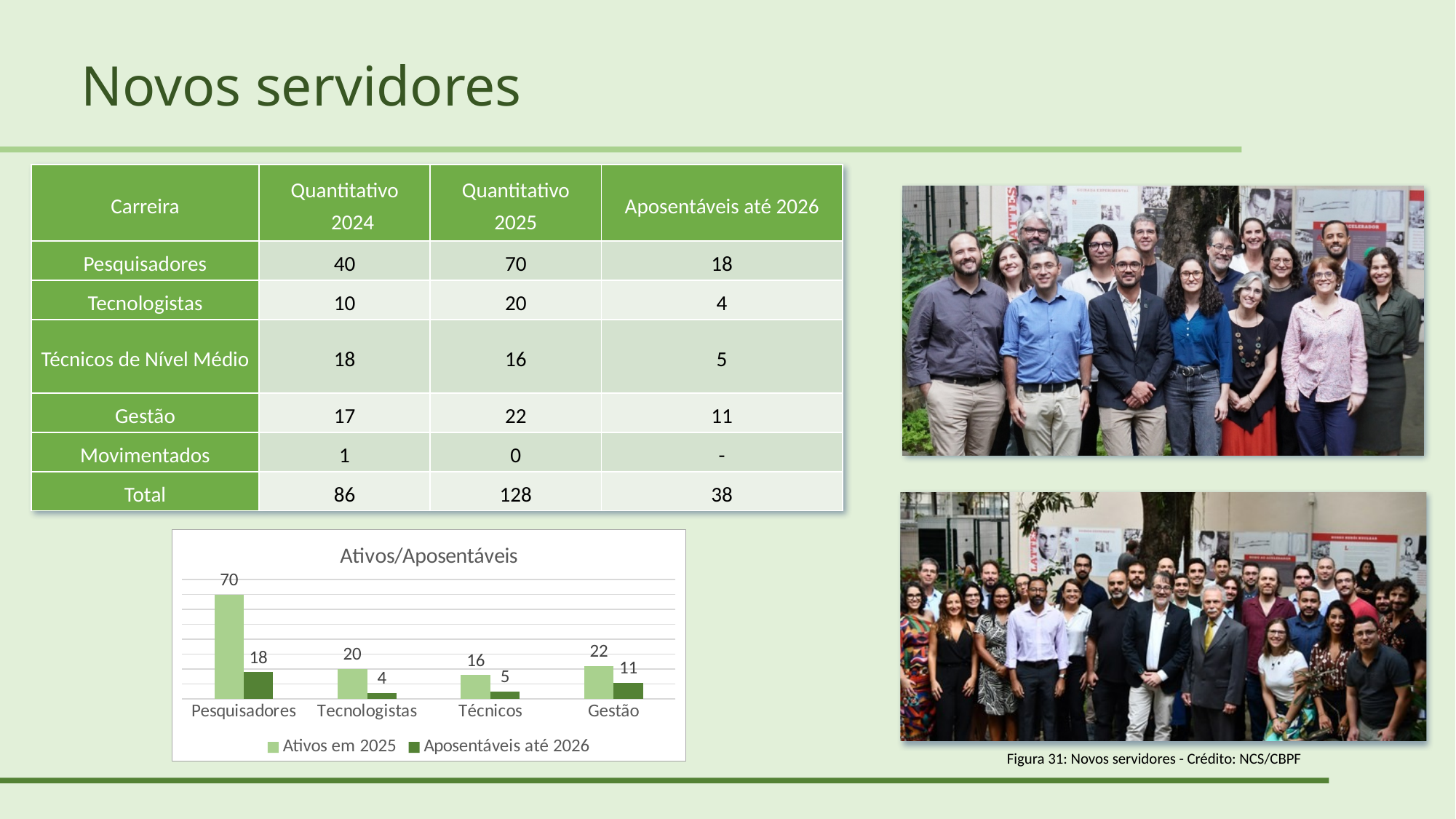
What is the value of Ativos em 2025 for Pesquisadores? 70 How many series does the chart legend list? 2 What is the value of Aposentáveis até 2026 for Gestão? 11 What are the two series named in the chart legend? Ativos em 2025 and Aposentáveis até 2026 How many categories are shown on the x axis of the chart? 4 What is the value of Aposentáveis até 2026 for Tecnologistas? 4 What is the title of the chart? Ativos/Aposentáveis What is the difference between Ativos em 2025 and Aposentáveis até 2026 for Pesquisadores? 52 Which category has the lowest value for Aposentáveis até 2026? Tecnologistas Which category has the highest value for Ativos em 2025? Pesquisadores What type of chart is shown on the slide? bar chart Which is larger: Ativos em 2025 for Tecnologistas or Ativos em 2025 for Técnicos? Tecnologistas